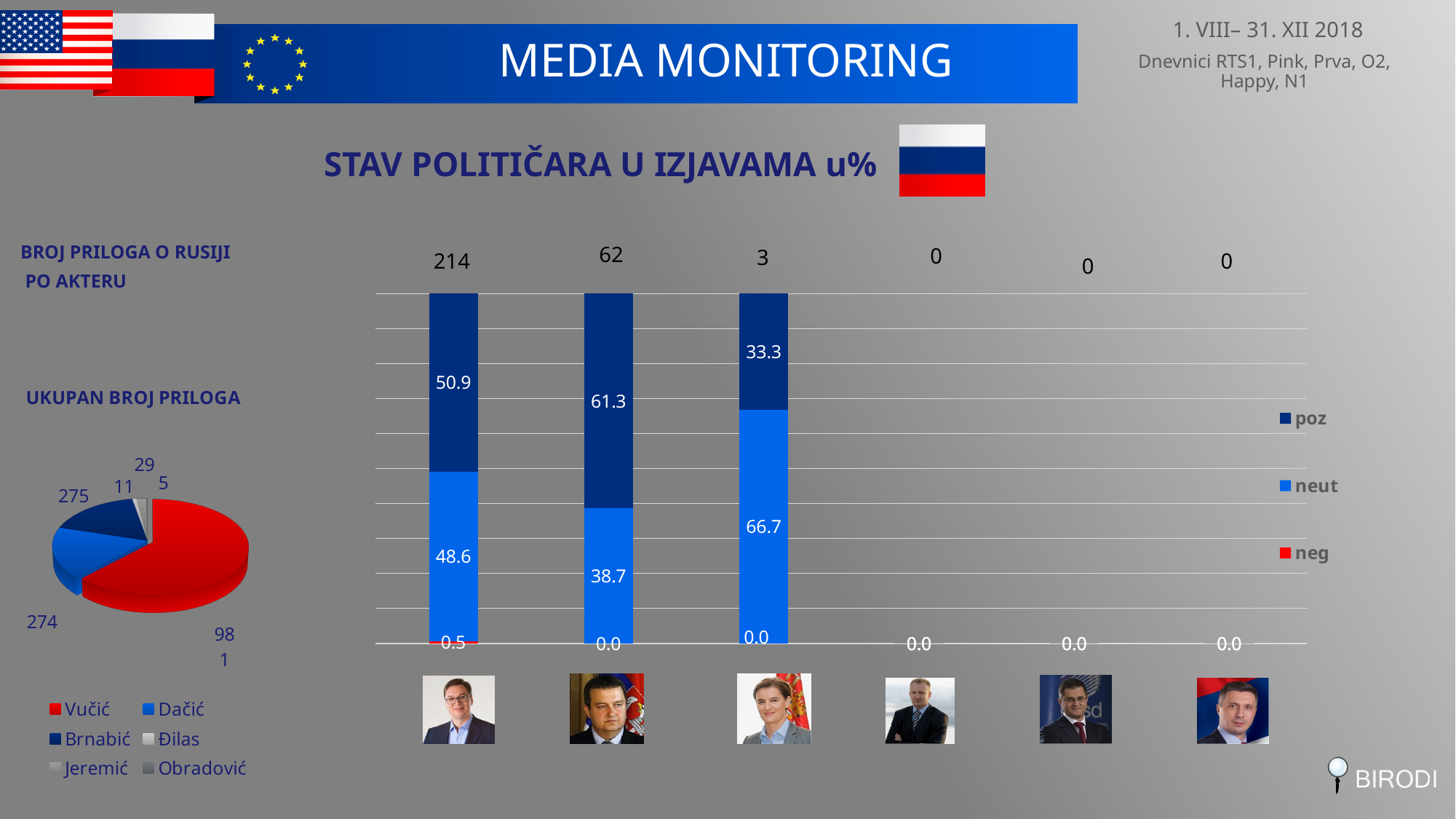
In the chart STAV POLITIČARA U IZJAVAMA u%, how many series does the legend list? 3 What kind of chart is the chart titled UKUPAN BROJ PRILOGA? pie chart In the pie chart UKUPAN BROJ PRILOGA, which category has the largest slice? Vučić In the chart STAV POLITIČARA U IZJAVAMA u%, what number is printed above the first (leftmost) bar? 214 In the chart STAV POLITIČARA U IZJAVAMA u%, how many bars (politicians) are shown? 6 In the chart STAV POLITIČARA U IZJAVAMA u%, what is the poz value for the first (leftmost) bar? 50.9 In the chart STAV POLITIČARA U IZJAVAMA u%, what is the neut value for the second bar? 38.7 In the chart STAV POLITIČARA U IZJAVAMA u%, what is the neg value for the first (leftmost) bar? 0.5 In the chart STAV POLITIČARA U IZJAVAMA u%, for the third bar, which is larger: the poz value or the neut value? neut What kind of chart is the chart titled STAV POLITIČARA U IZJAVAMA u%? stacked bar chart In the chart STAV POLITIČARA U IZJAVAMA u%, what is the difference between the poz and neut values of the second bar? 22.6 In the pie chart UKUPAN BROJ PRILOGA, how many categories does the legend list? 6